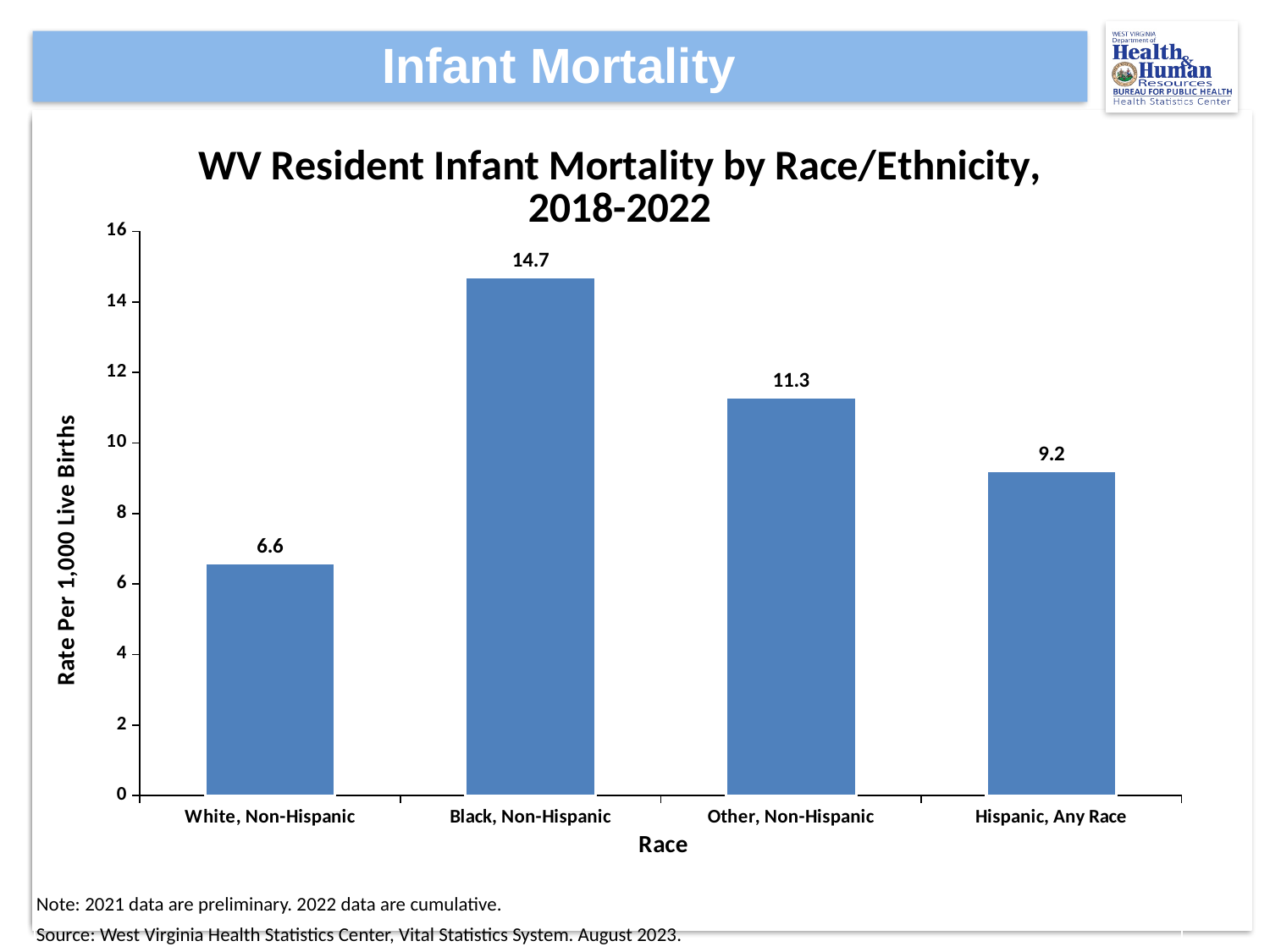
What is the difference between the infant mortality rates for Black, Non-Hispanic and White, Non-Hispanic residents? 8.1 What is the label of the vertical axis? Rate Per 1,000 Live Births What is the infant mortality rate for White, Non-Hispanic residents? 6.6 What is the infant mortality rate for Black, Non-Hispanic residents? 14.7 What type of chart is shown on the slide? Bar chart Which group has a higher infant mortality rate, Other, Non-Hispanic or Hispanic, Any Race? Other, Non-Hispanic Which race/ethnicity group has the highest infant mortality rate? Black, Non-Hispanic Which race/ethnicity group has the lowest infant mortality rate? White, Non-Hispanic What is the infant mortality rate for Hispanic, Any Race residents? 9.2 What is the title of the chart? WV Resident Infant Mortality by Race/Ethnicity, 2018-2022 How many race/ethnicity categories are shown in the chart? 4 Is the value for Other, Non-Hispanic greater or less than 10? greater